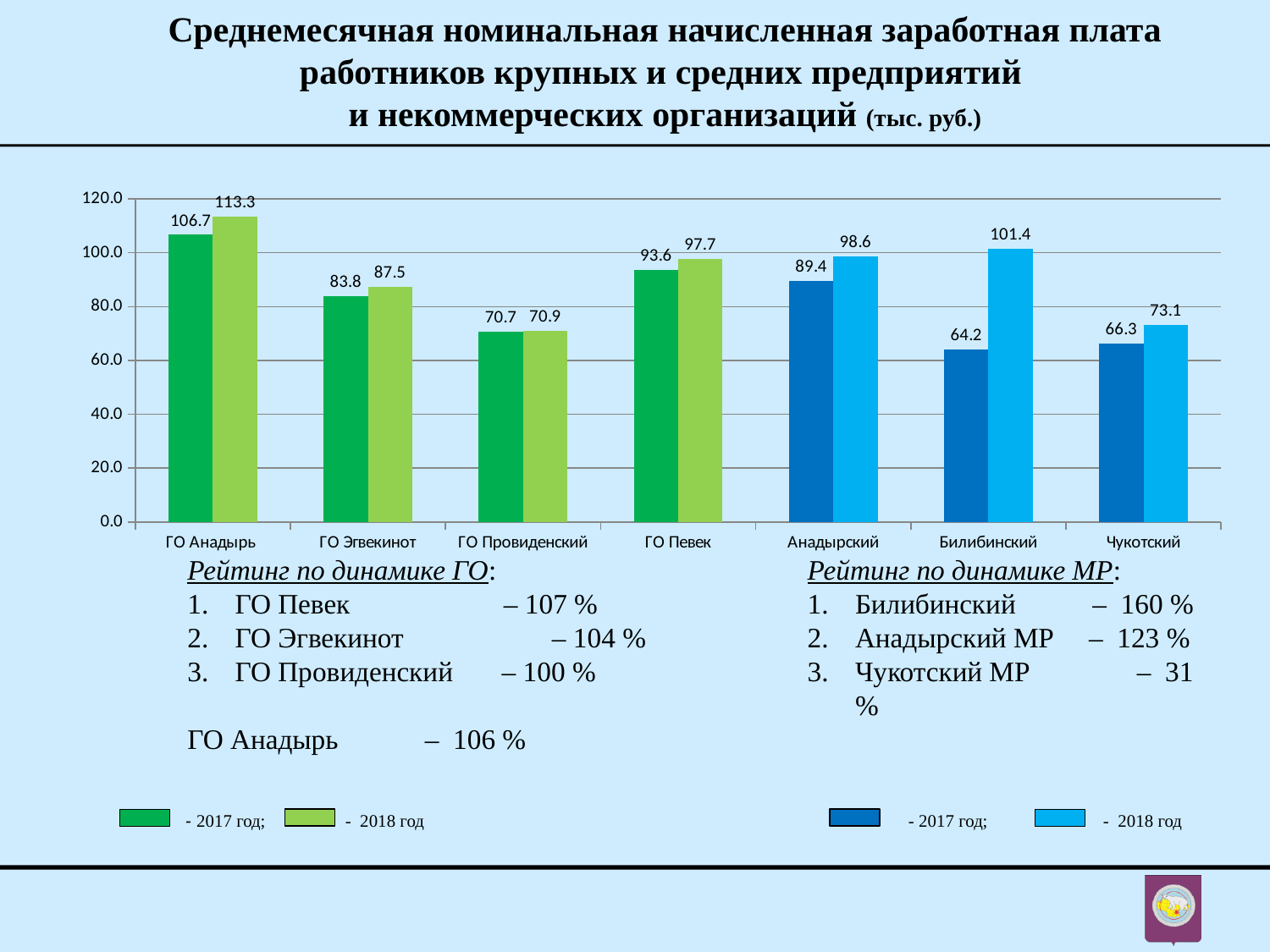
What is the 2018 value for ГО Анадырь? 113.3 What is the difference between the 2018 values for ГО Анадырь and Чукотский? 40.2 Which is larger: the 2018 value for Анадырский or the 2018 value for ГО Певек? Анадырский Which category has the highest 2018 value? ГО Анадырь How many categories are shown on the x axis? 7 What kind of chart is shown on the slide? bar chart What is the 2017 value for Билибинский? 64.2 What is the 2017 value for ГО Певек? 93.6 Which category has the lowest 2017 value? Билибинский What is the difference between the 2018 and 2017 values for Билибинский? 37.2 What unit is given in the chart title? тыс. руб. Is the 2017 value for Чукотский greater or less than 80.0? less